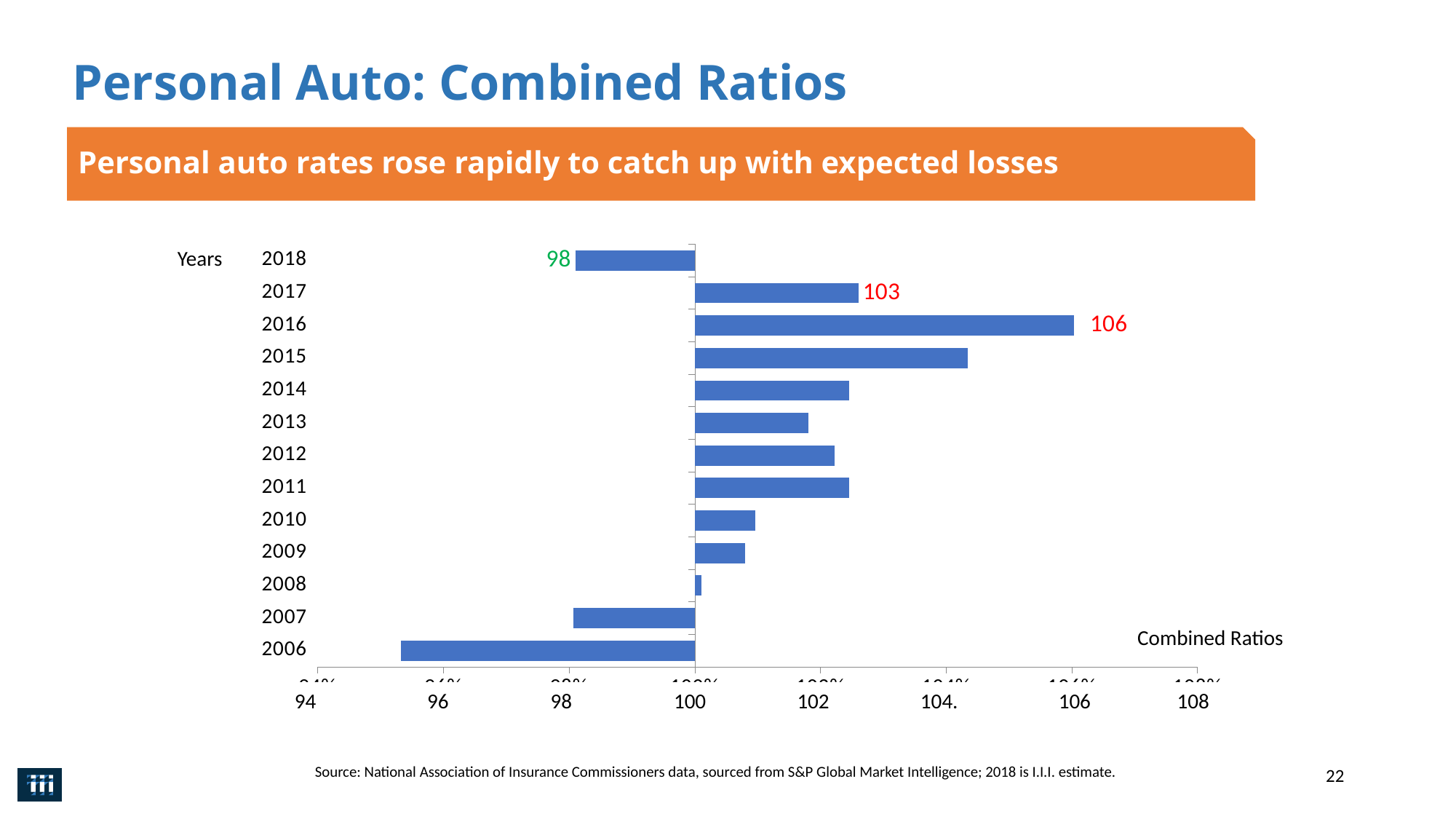
What is the combined ratio for 2016? 106 What is the difference between the combined ratios for 2017 and 2018? 5 What is the difference between the combined ratios for 2016 and 2017? 3 Is the combined ratio for 2014 greater or less than 102? greater What kind of chart is shown on the slide? Bar chart Which year has the highest combined ratio? 2016 What is the combined ratio for 2018? 98 Which year has the larger combined ratio, 2016 or 2017? 2016 What is the combined ratio for 2017? 103 Which year has the lowest combined ratio? 2006 How many years are shown in the chart? 13 Is the combined ratio for 2006 greater or less than 96? less